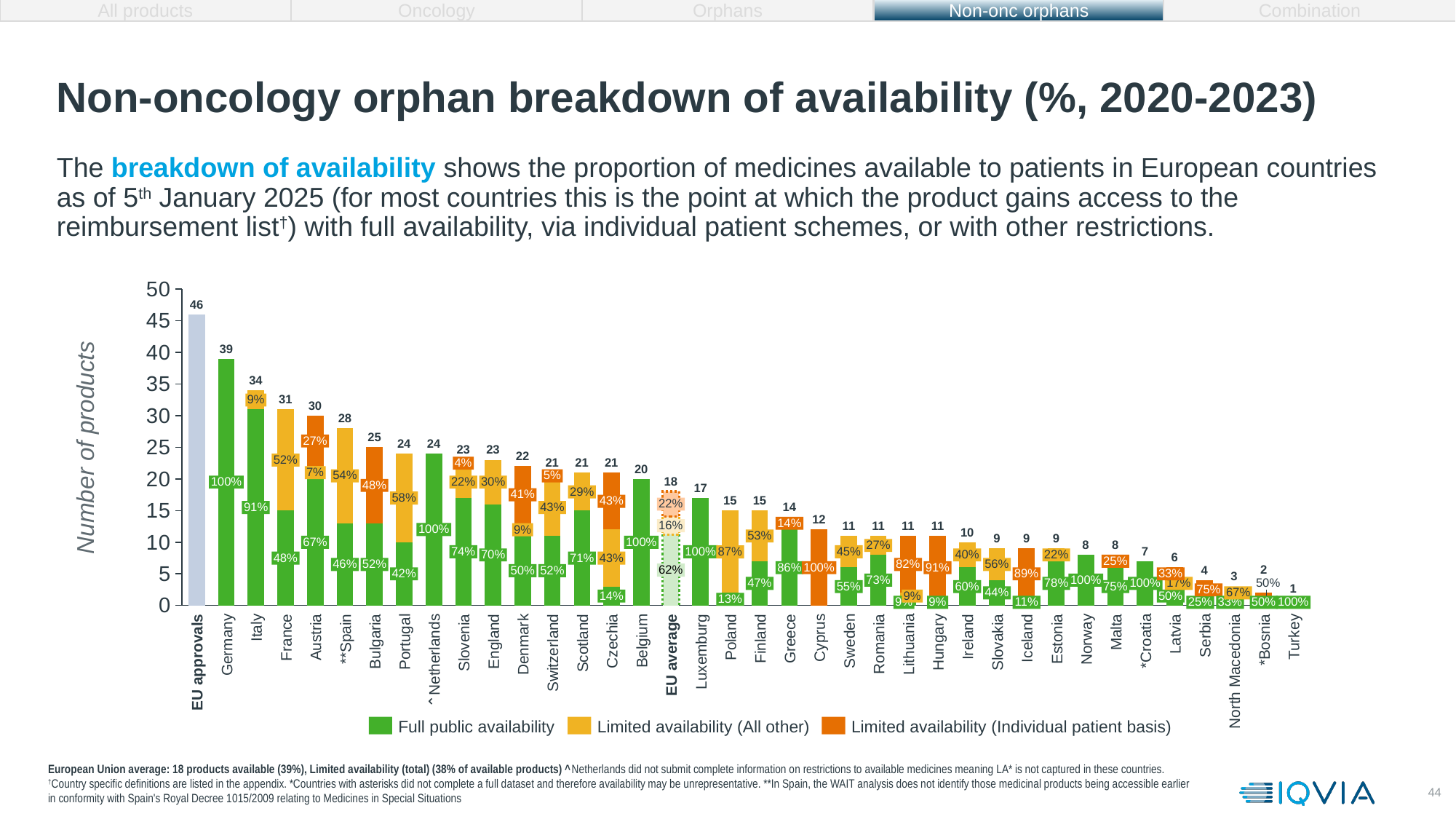
How many series does the legend list? 3 Do the total number of products rise or fall moving from left to right along the x axis? Fall What percentage of Italy's available products have full public availability? 91% What is the total number of products shown for the EU average bar? 18 What kind of chart is shown on the slide? Stacked bar chart What is the total number of products shown for EU approvals? 46 What is the total number of products shown for Germany? 39 Which has a larger total number of products, Poland or Greece? Poland What is the difference in total products between Germany and Italy? 5 What percentage of Cyprus's available products are limited availability on an individual patient basis? 100% Which country (excluding the EU approvals bar) has the highest total number of products? Germany Which country has the lowest total number of products? Turkey